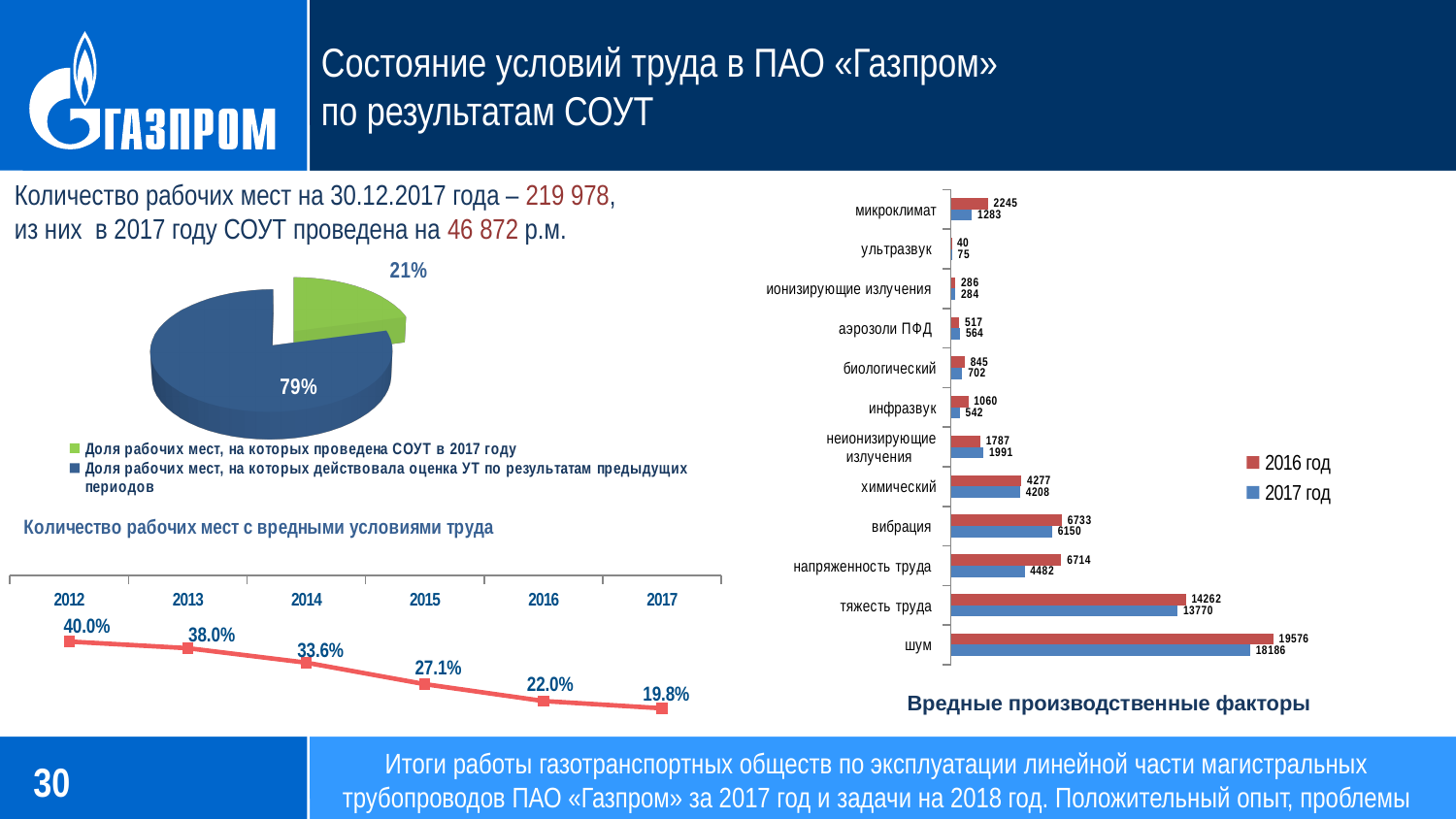
In the bar chart 'Вредные производственные факторы', what is the 2016 value for шум? 19576 In the pie chart on the left, what is the value of the blue slice (workplaces with an assessment from previous periods)? 79% In the bar chart 'Вредные производственные факторы', what is the 2017 value for тяжесть труда? 13770 In the line chart 'Количество рабочих мест с вредными условиями труда', what is the difference between the 2014 and 2015 values? 6.5% In the bar chart 'Вредные производственные факторы', which factor has the highest value in 2017? шум In the line chart 'Количество рабочих мест с вредными условиями труда', what is the value for 2017? 19.8% In the bar chart 'Вредные производственные факторы', which factor has the lowest value in 2016? ультразвук In the line chart 'Количество рабочих мест с вредными условиями труда', how many years are plotted? 6 In the line chart 'Количество рабочих мест с вредными условиями труда', what is the value for 2012? 40.0% In the bar chart 'Вредные производственные факторы', how many series does the legend list? 2 In the pie chart on the left, what share of workplaces had SOUT conducted in 2017 (the green slice)? 21% In the line chart 'Количество рабочих мест с вредными условиями труда', do the values rise or fall from 2012 to 2017? fall